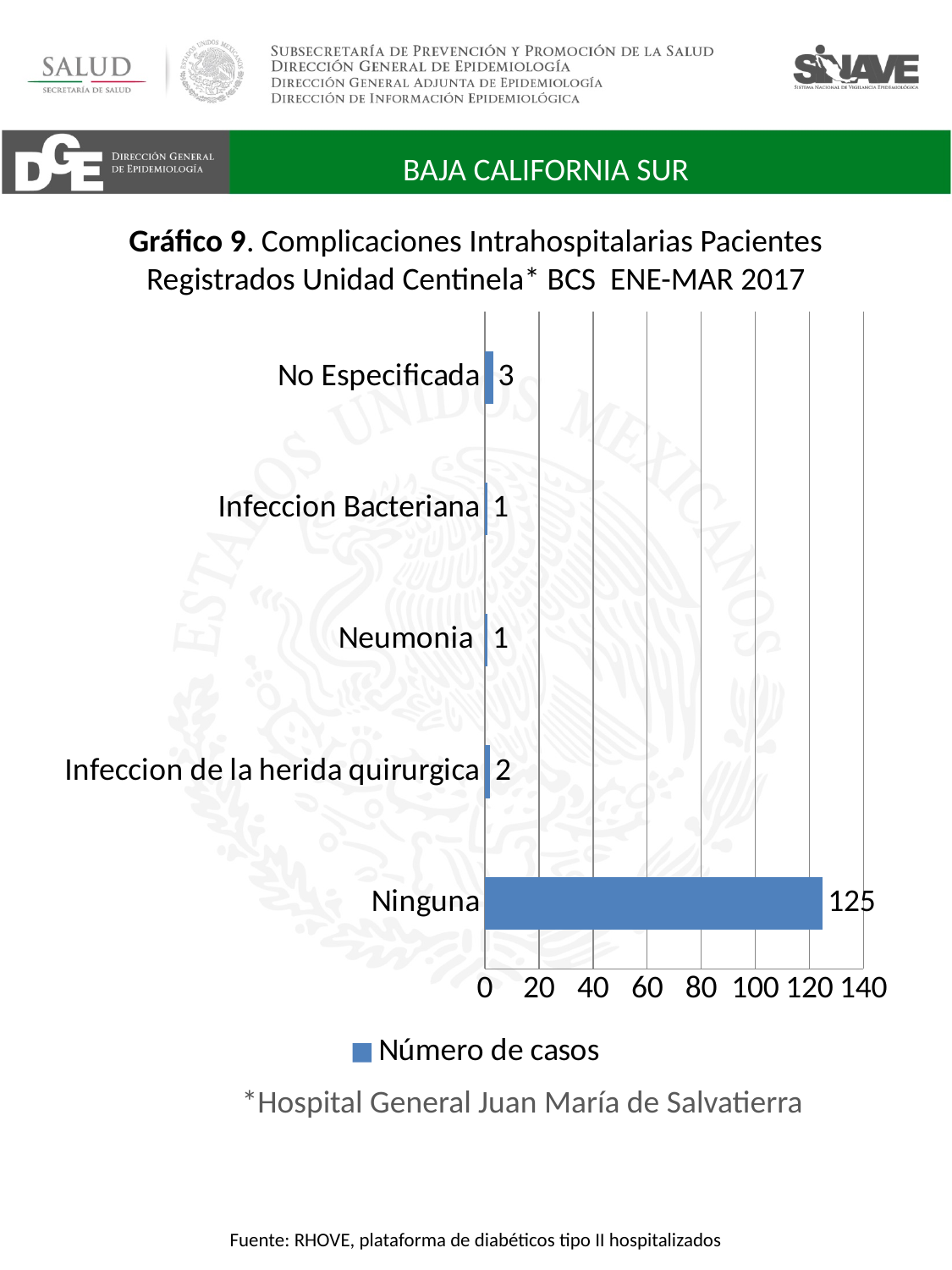
What kind of chart is shown on the slide? Bar chart What is the number of cases for Infeccion de la herida quirurgica? 2 What is the number of cases for Neumonia? 1 Which has more cases, No Especificada or Infeccion de la herida quirurgica? No Especificada How many series does the legend list? 1 What is the legend entry of the chart? Número de casos What is the difference in number of cases between Ninguna and No Especificada? 122 What is the number of cases for Ninguna? 125 Is the value for Ninguna greater or less than 120? greater Which category has the highest number of cases? Ninguna How many categories are shown in the chart? 5 What is the number of cases for No Especificada? 3